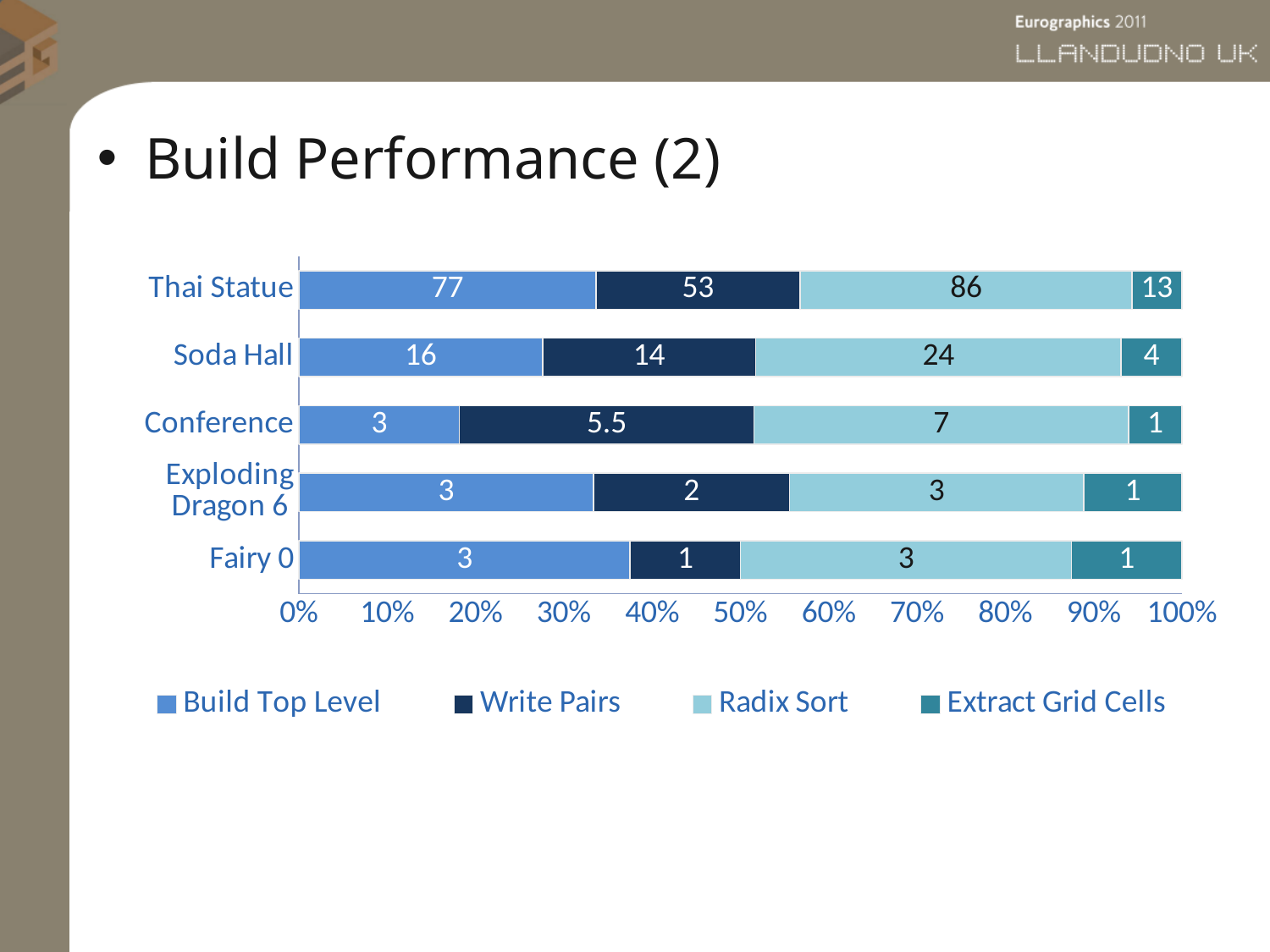
How many categories are shown on the y axis? 5 What is the Build Top Level value for Soda Hall? 16 What is the total of the four values in the Soda Hall bar? 58 What kind of chart is shown on the slide? Stacked bar chart How many series does the legend list? 4 Which category has the lowest Write Pairs value? Fairy 0 What is the difference between the Radix Sort and Write Pairs values for Thai Statue? 33 Which category has the highest Radix Sort value? Thai Statue What is the Radix Sort value for Thai Statue? 86 What is the Write Pairs value for Conference? 5.5 What is the Extract Grid Cells value for Thai Statue? 13 Which is larger for Soda Hall, Build Top Level or Write Pairs? Build Top Level